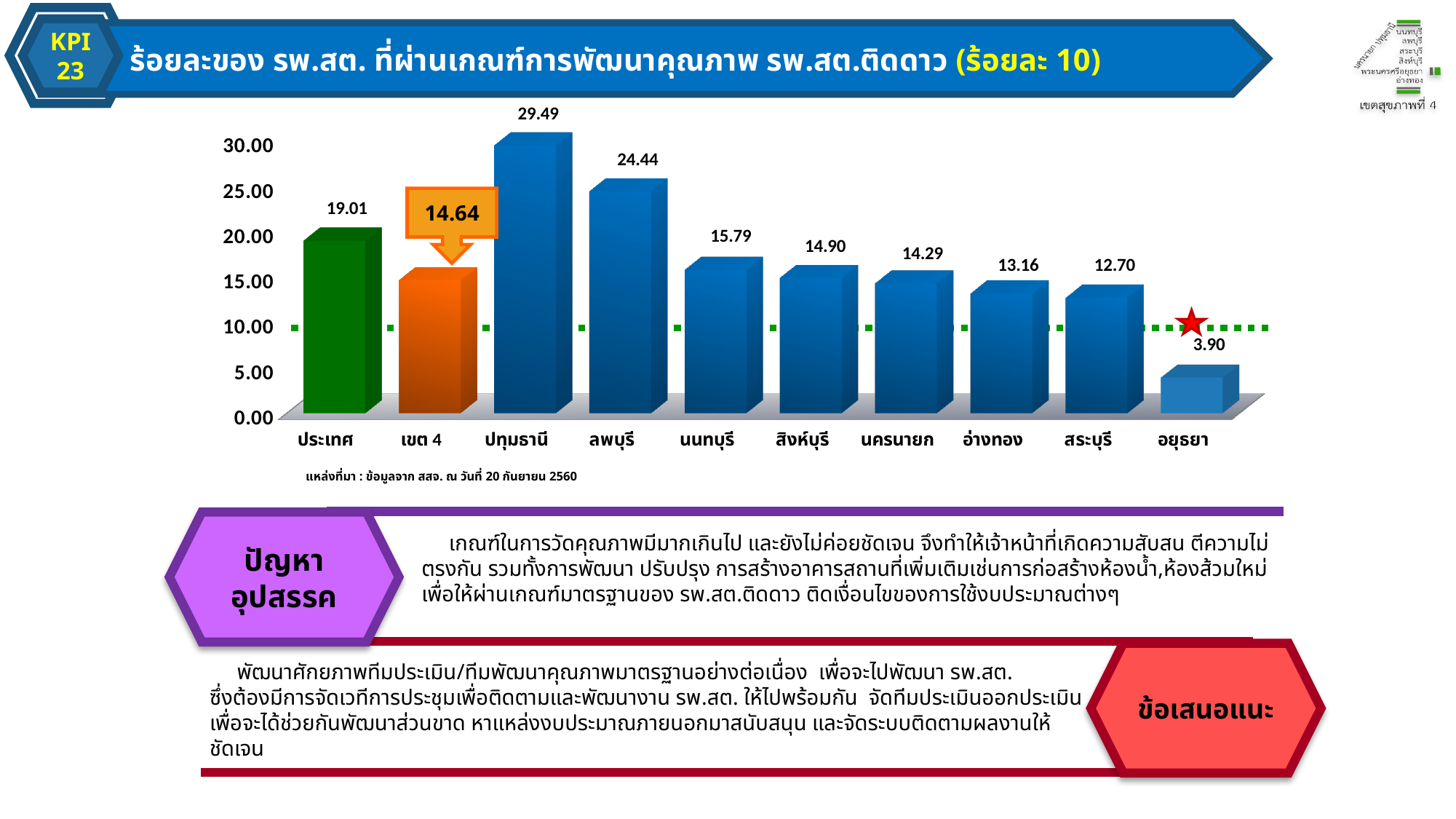
What is the value for อยุธยา? 3.90 What is the value for เขต 4? 14.64 What is the difference between the values for ประเทศ and เขต 4? 4.37 What is the value for ปทุมธานี? 29.49 Which category has the highest value? ปทุมธานี Is the value for อยุธยา greater or less than 10.00? less Which category has the lowest value? อยุธยา How many categories are shown on the x axis? 10 What is the value for ประเทศ? 19.01 What is the difference between the values for ปทุมธานี and ลพบุรี? 5.05 Which is larger, the value for นนทบุรี or the value for สิงห์บุรี? นนทบุรี What kind of chart is shown on the slide? bar chart